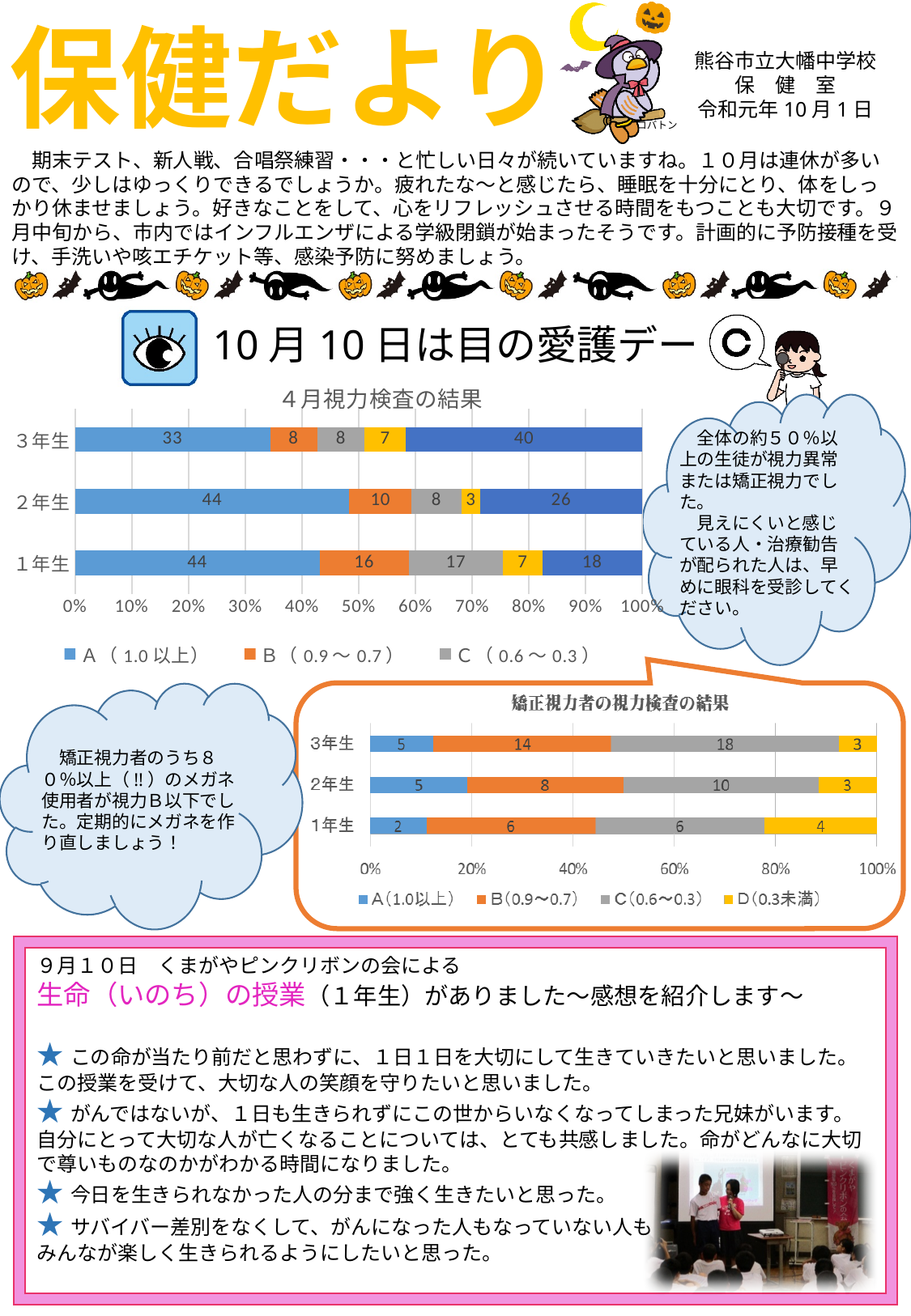
In the chart titled 「４月視力検査の結果」, what is the value of series C（0.6～0.3） for ２年生? 8 In the chart titled 「４月視力検査の結果」, what is the value of series A（1.0 以上） for ３年生? 33 In the chart titled 「４月視力検査の結果」, how many grade categories are shown? 3 In the chart titled 「４月視力検査の結果」, what is the value of series B（0.9～0.7） for １年生? 16 In the chart titled 「４月視力検査の結果」, which grade has the highest value for series C（0.6～0.3）? １年生 In the chart titled 「矯正視力者の視力検査の結果」, what is the value of series C（0.6～0.3） for ３年生? 18 What kind of chart is 「矯正視力者の視力検査の結果」? Stacked bar chart In the chart titled 「矯正視力者の視力検査の結果」, what is the value of series D（0.3未満） for １年生? 4 In the chart titled 「矯正視力者の視力検査の結果」, what is the total of the stacked bar for ２年生? 26 In the chart titled 「４月視力検査の結果」, what is the difference between the A（1.0 以上） values for ２年生 and ３年生? 11 In the chart titled 「矯正視力者の視力検査の結果」, which is larger: the B（0.9～0.7） value for ３年生 or for ２年生? ３年生 In the chart titled 「矯正視力者の視力検査の結果」, how many series does the legend list? 4